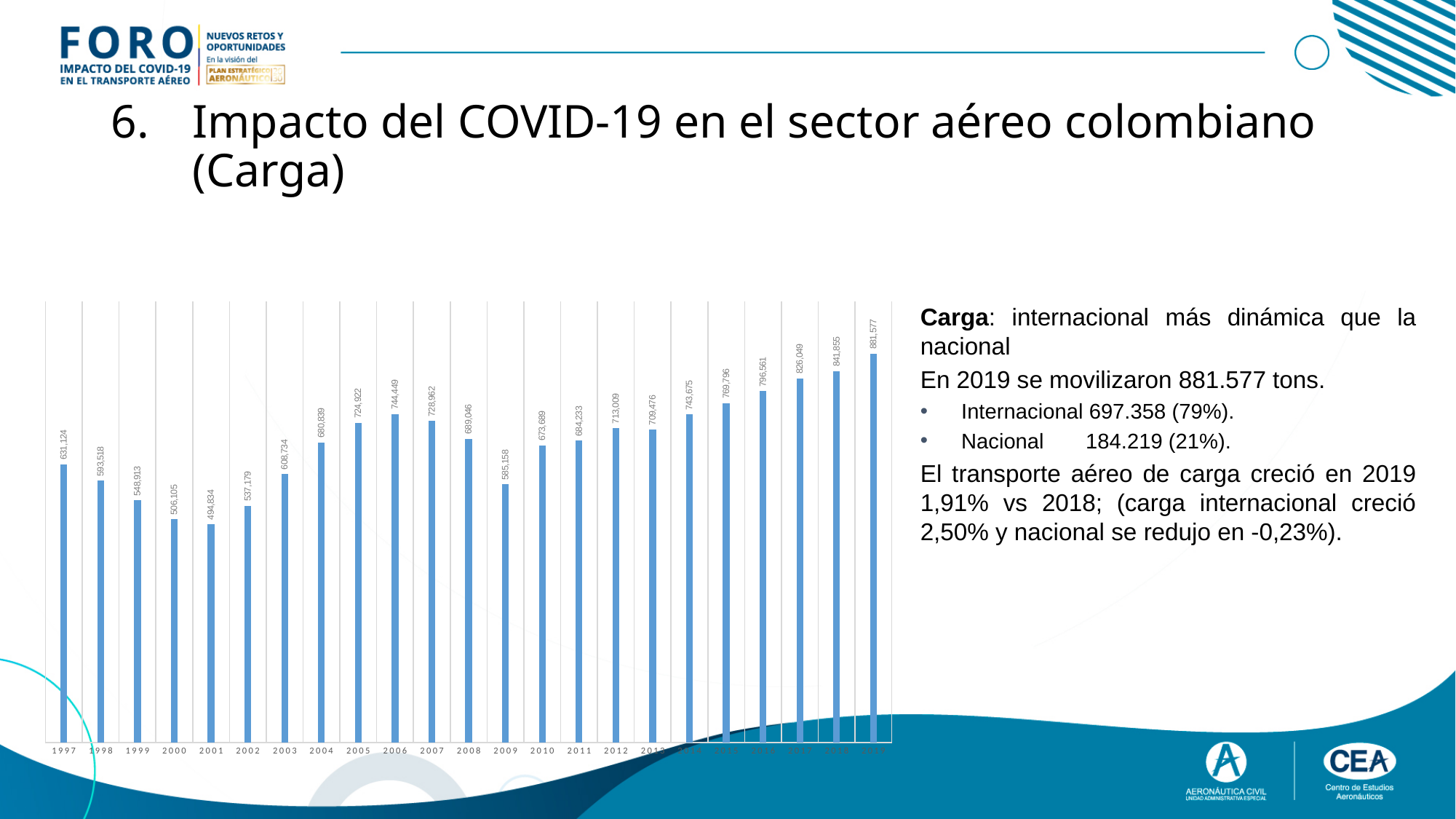
What is the value shown for 2006? 744,449 What is the value shown for 2009? 585,158 What is the difference between the values for 2005 and 2004? 44,083 Do the values rise or fall from 1997 to 2001? fall What is the difference between the values for 1997 and 1998? 37,606 Which is larger, the value for 2003 or the value for 2010? 2010 Which year has the lowest value in the chart? 2001 What is the highest value labelled on the chart? 881,577 What kind of chart is shown on the slide? bar chart What is the value shown for 1997? 631,124 What is the value shown for 2001? 494,834 How many bars are plotted in the chart? 23